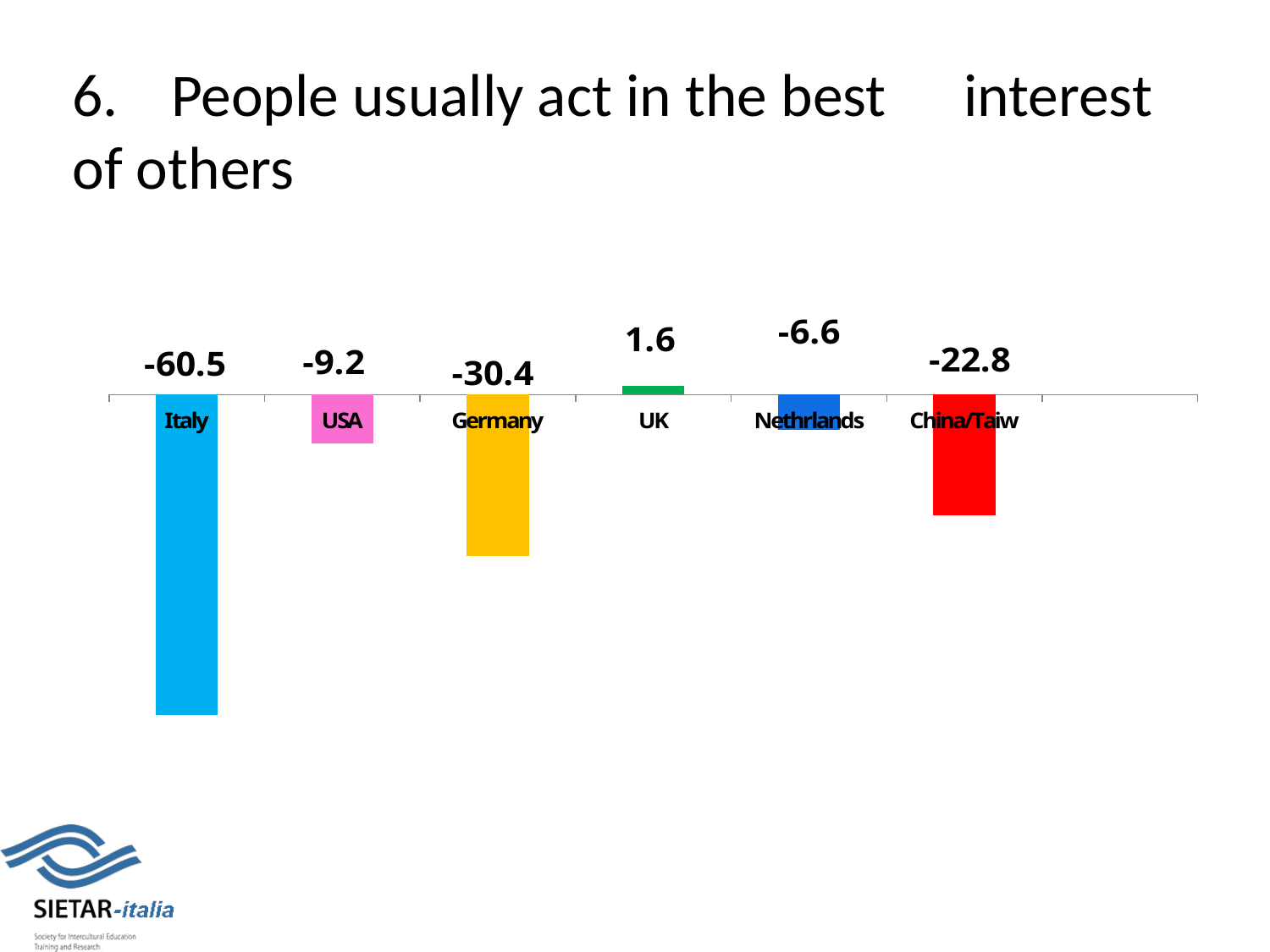
Which category has the highest value? UK What is the difference between the values for Germany and China/Taiw? 7.6 What is the value for the UK? 1.6 What kind of chart is shown on the slide? Bar chart What is the value for Italy? -60.5 What is the value for China/Taiw? -22.8 Which category has the lowest value? Italy What is the value for Germany? -30.4 How many categories have a positive value? 1 Which is larger, the value for USA or the value for Nethrlands? Nethrlands What colour is the bar for Germany? Yellow How many categories are shown in the chart? 6